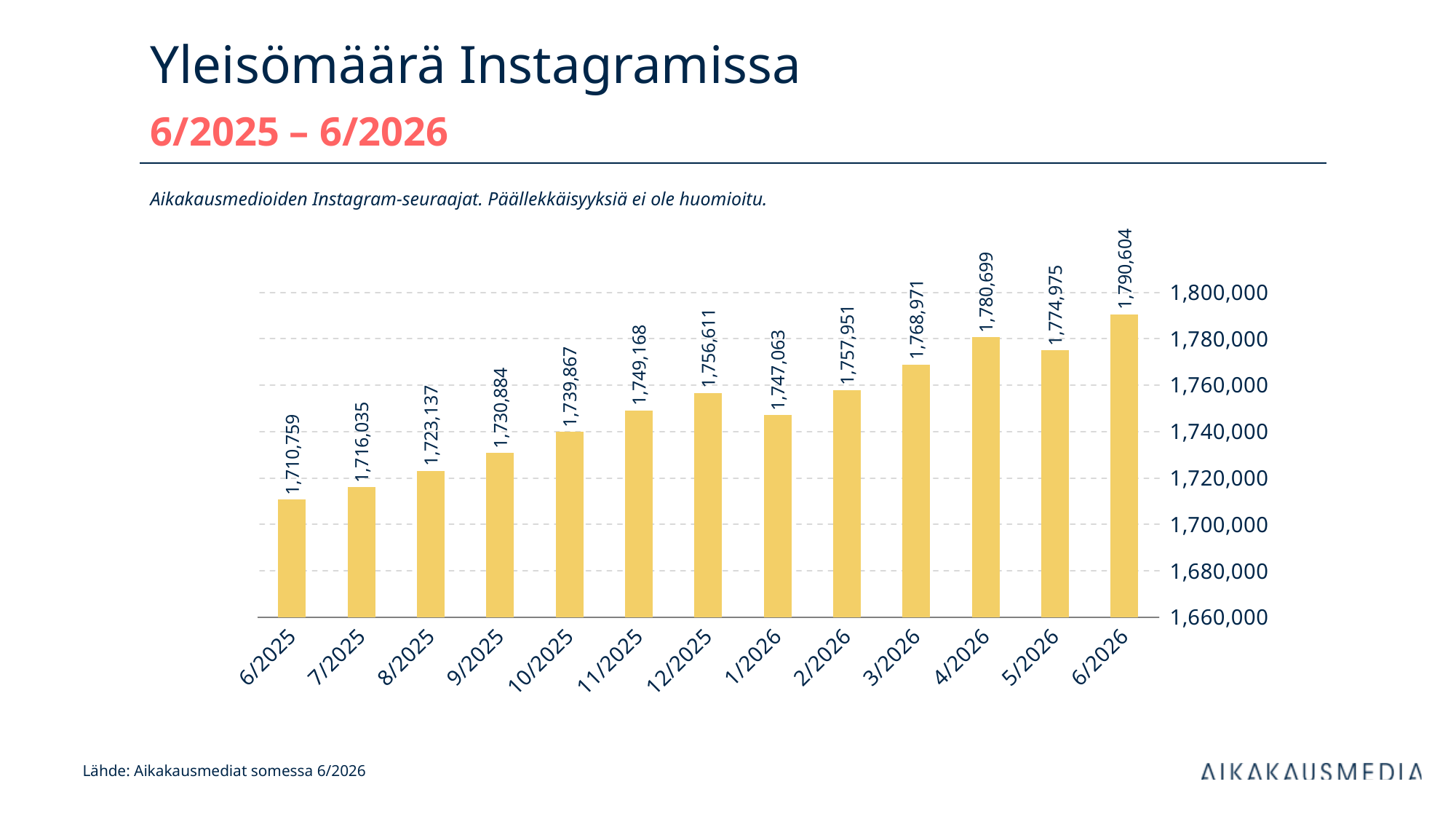
What is the value for 4/2026? 1,780,699 Which month has the highest value? 6/2026 Which is larger, the value for 4/2026 or the value for 5/2026? 4/2026 What is the value for 6/2025? 1,710,759 Is the value for 9/2025 greater or less than 1,740,000? less Which month has the lowest value? 6/2025 How many months are shown on the x axis? 13 What kind of chart is shown on the slide? bar chart What is the difference between the values for 6/2026 and 6/2025? 79,845 What is the title of the chart on the slide? Yleisömäärä Instagramissa What is the value for 1/2026? 1,747,063 What is the difference between the values for 12/2025 and 1/2026? 9,548